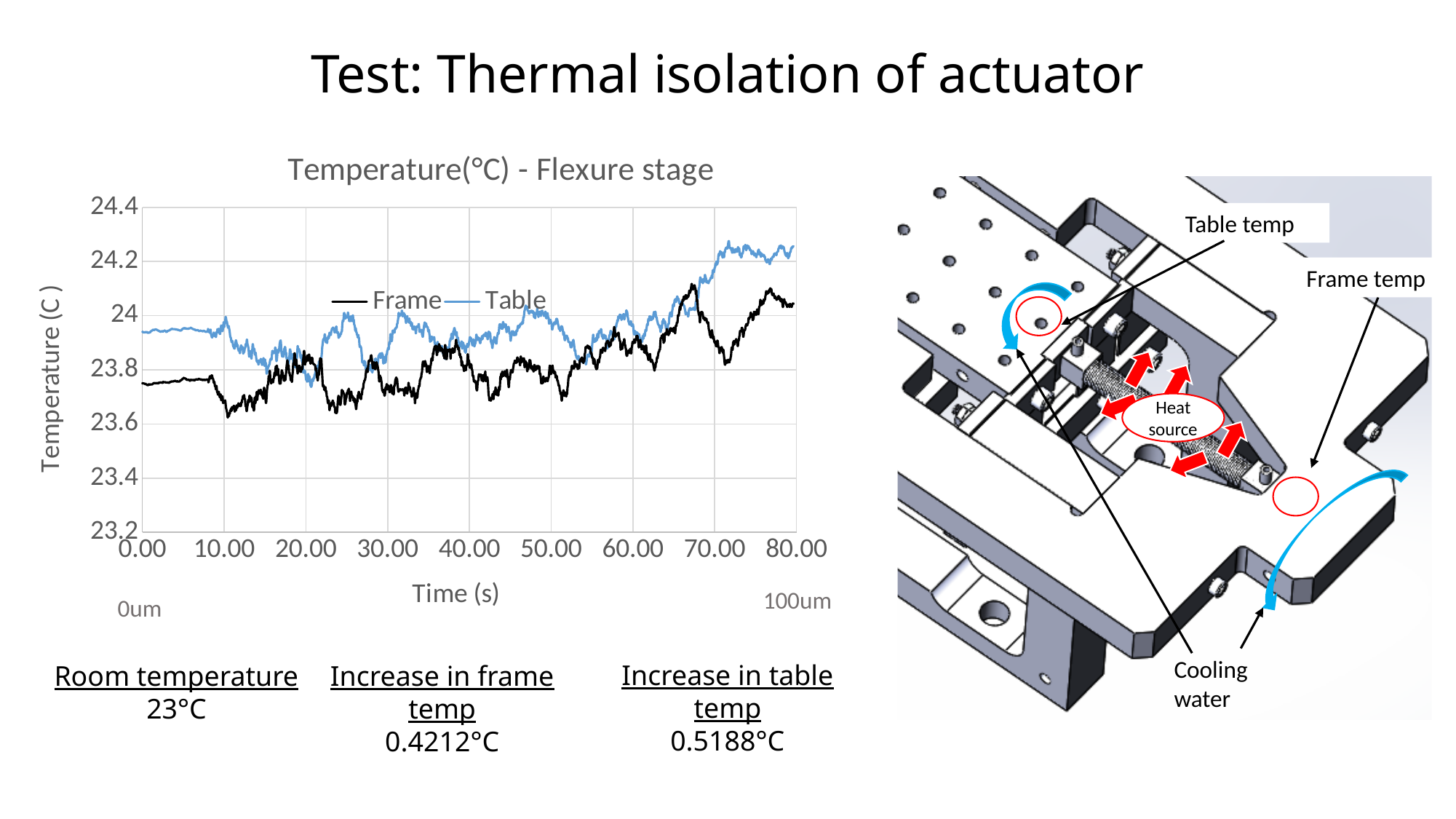
How many series does the chart legend list? 2 Is the Frame temperature at time 0.00 s greater or less than 23.8? less Does the Table temperature overall rise or fall from 0.00 s to 80.00 s? rise Is the Frame temperature at time 80.00 s greater or less than 23.8? greater Is the Table temperature at time 0.00 s greater or less than 24? less What is the label of the x axis of the chart? Time (s) What kind of chart is shown on the slide? line chart What is the title of the chart? Temperature(°C) - Flexure stage Which series is plotted in blue, Frame or Table? Table At time 0.00 s, which series has the higher temperature, Frame or Table? Table Does the Frame temperature overall rise or fall from 0.00 s to 80.00 s? rise